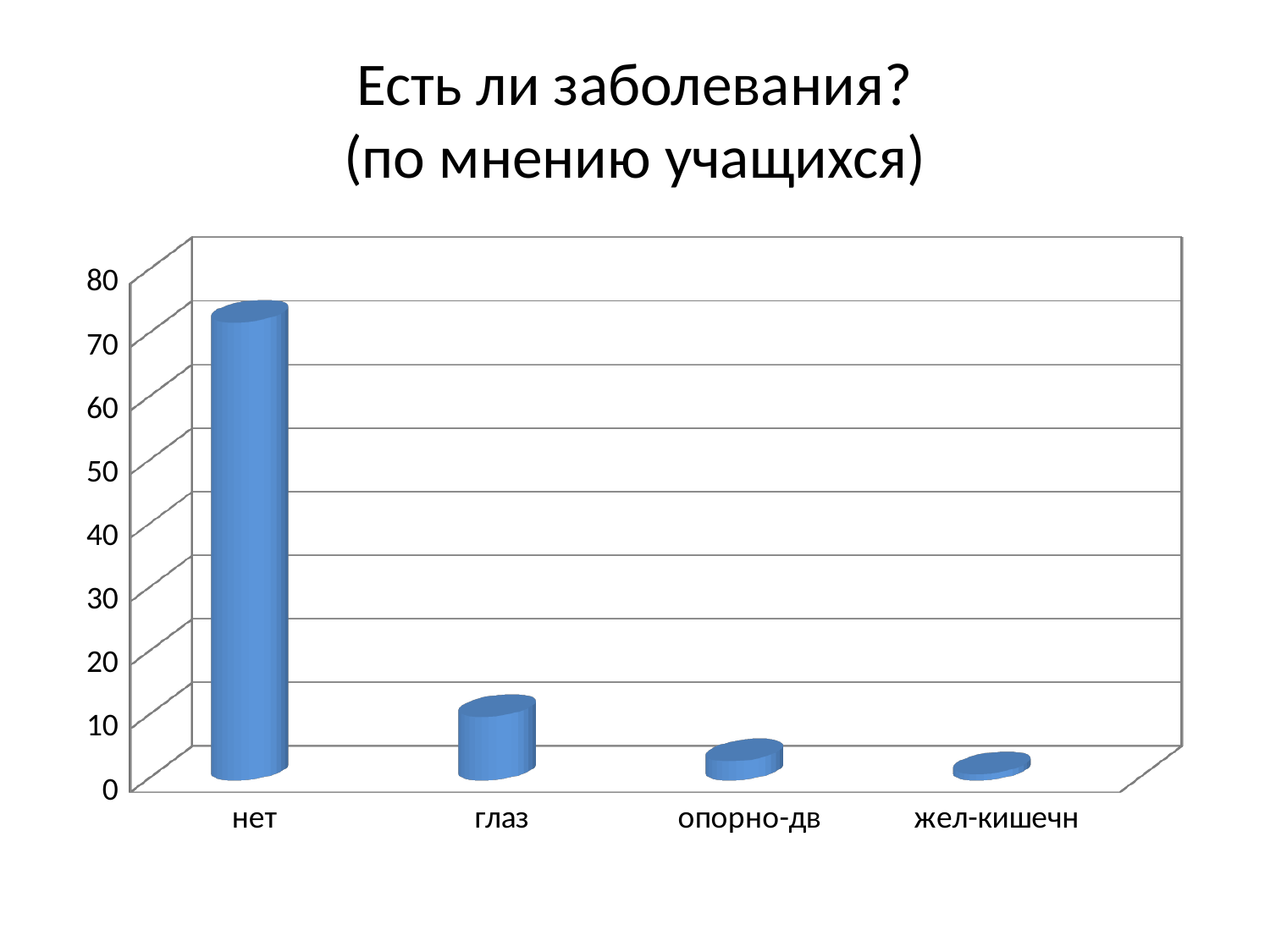
What is the title of the chart on the slide? Есть ли заболевания? (по мнению учащихся) Is the value for глаз greater or less than 20? less What kind of chart is shown on the slide? Bar chart Is the value for жел-кишечн greater or less than 10? less Which category has the lowest value in the chart? жел-кишечн Is the value for опорно-дв greater or less than 10? less Which is larger, the value for нет or the value for глаз? нет Do the values rise or fall from left to right along the x axis? fall Which category has the highest value in the chart? нет How many categories are shown on the x axis of the chart? 4